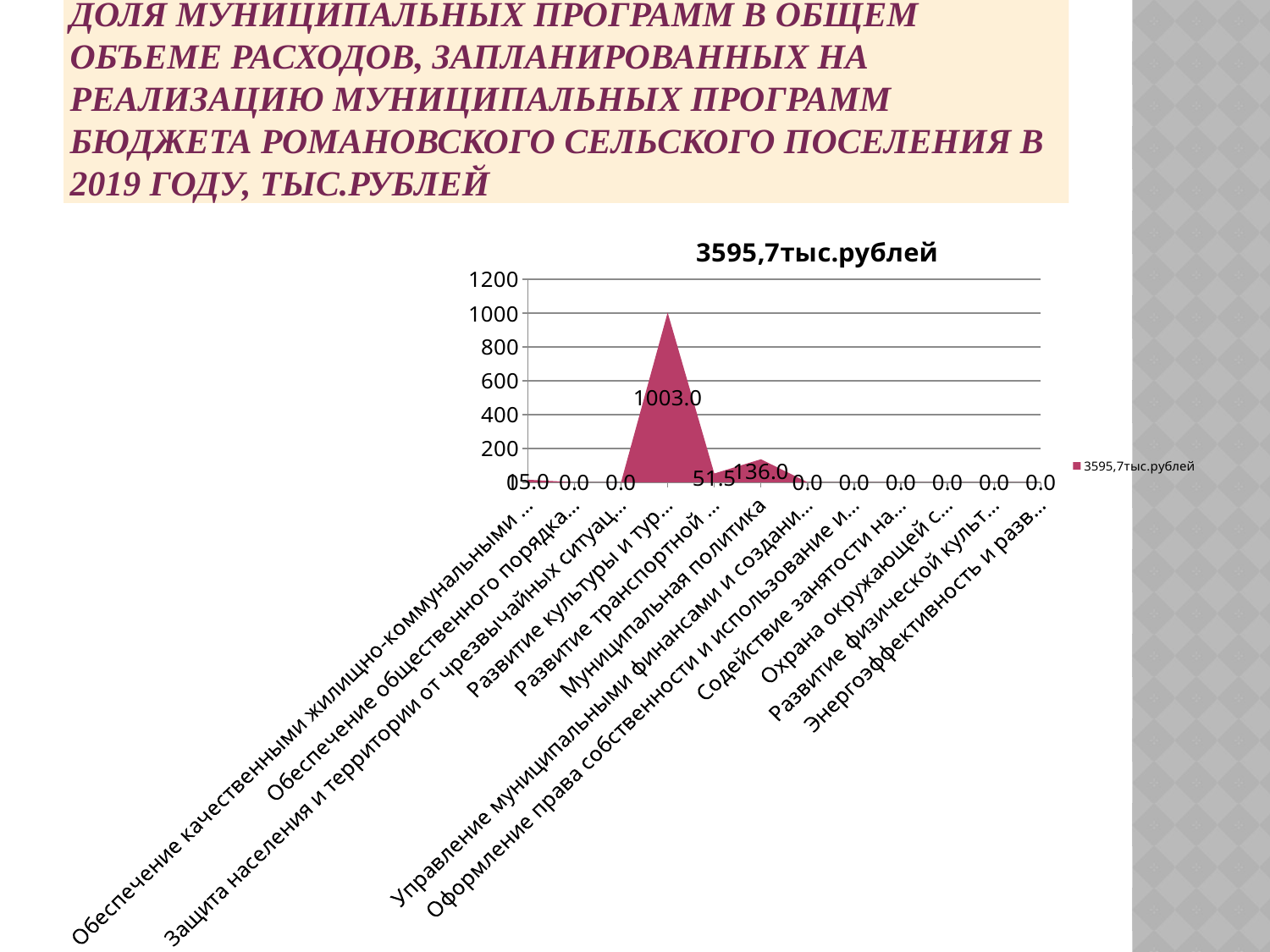
Which is larger: the value for Муниципальная политика or the value for Развитие транспортной ...? Муниципальная политика Which category has the highest value? Развитие культуры и тур... What is the value for the category Охрана окружающей с...? 0.0 How many series does the legend list? 1 What is the difference between the value for Муниципальная политика and the value for Развитие транспортной ...? 84.5 What is the value for Муниципальная политика? 136.0 What is the difference between the value for Развитие культуры и тур... and the value for Муниципальная политика? 867.0 Is the value for Развитие культуры и тур... greater or less than 800? greater How many categories are shown on the x axis? 12 What kind of chart is shown on the slide? area chart What is the value for the category Развитие культуры и тур...? 1003.0 What is the value for the category Развитие транспортной ...? 51.5